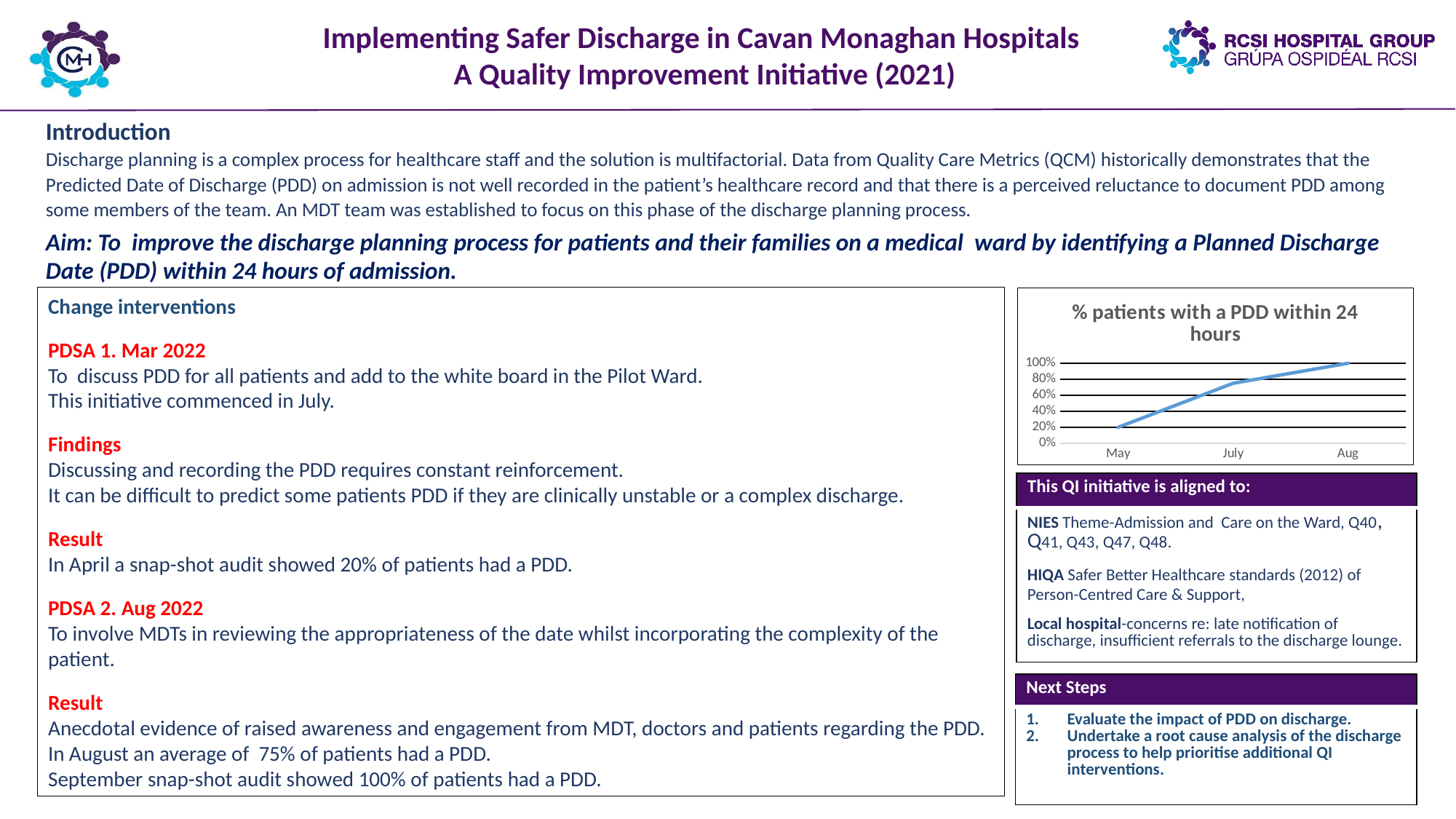
Is the value for July greater or less than 80%? less Is the value for July greater or less than 40%? greater Is the value for May greater or less than 60%? less Do the values in the chart rise or fall from May to Aug? rise Which months are shown on the x axis of the chart? May, July, Aug Which month has the highest % of patients with a PDD within 24 hours? Aug Which month has the lowest % of patients with a PDD within 24 hours? May What kind of chart is shown on the slide? line chart Which is larger, the value for Aug or the value for May? Aug What is the title of the chart on the slide? % patients with a PDD within 24 hours How many months are plotted on the x axis of the chart? 3